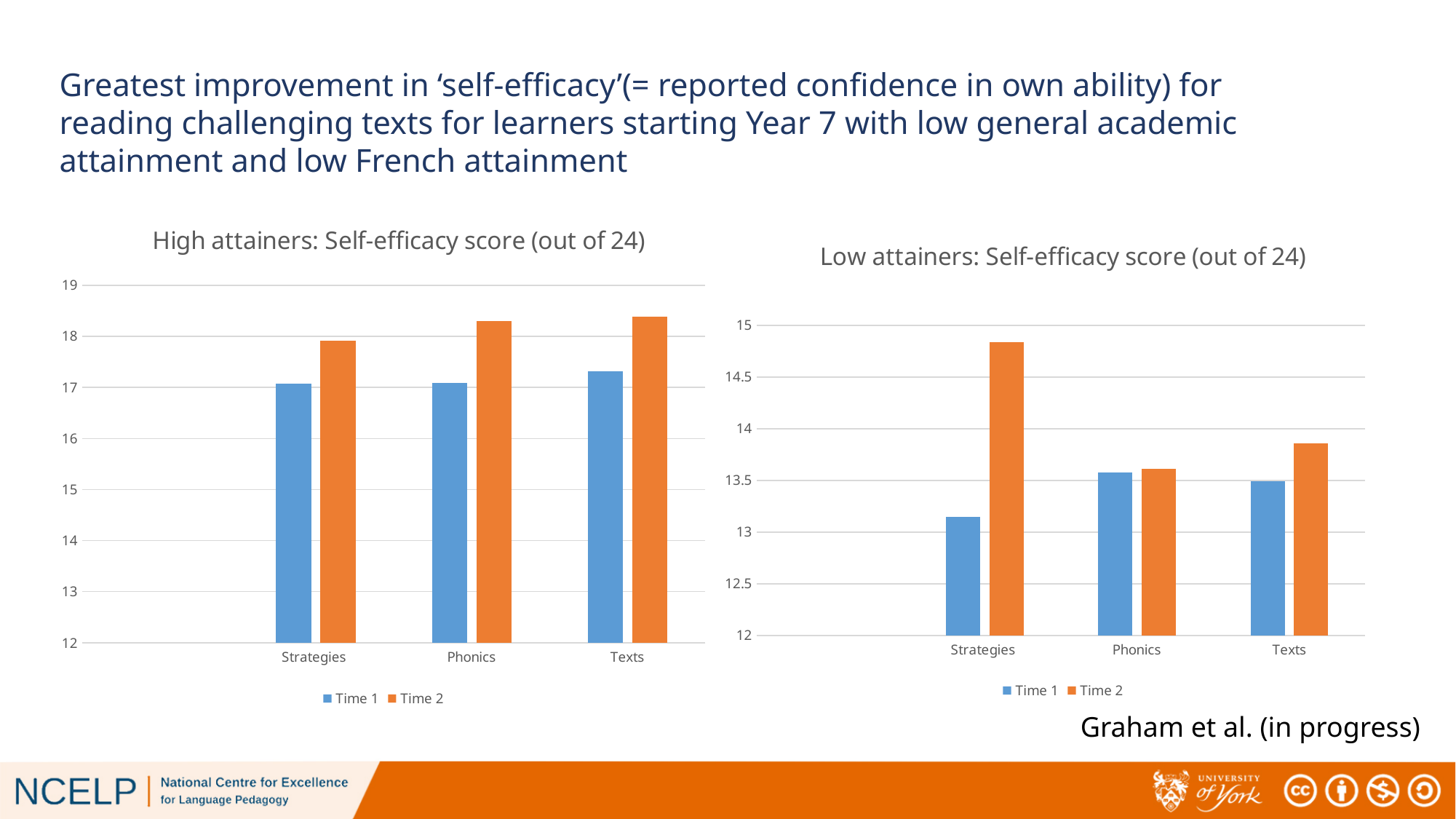
In the 'Low attainers: Self-efficacy score (out of 24)' chart, which category has the highest Time 2 value? Strategies What kind of chart is the 'High attainers: Self-efficacy score (out of 24)' chart? bar chart Which colour represents Time 2 in the 'High attainers: Self-efficacy score (out of 24)' chart? orange In the 'Low attainers: Self-efficacy score (out of 24)' chart, is the Time 2 value for Texts greater or less than 14? less How many categories are shown on the x axis of the 'High attainers: Self-efficacy score (out of 24)' chart? 3 In the 'High attainers: Self-efficacy score (out of 24)' chart, is the Time 2 value for Texts greater or less than 18? greater In the 'Low attainers: Self-efficacy score (out of 24)' chart, is the Time 2 value for Strategies greater or less than 14.5? greater In the 'Low attainers: Self-efficacy score (out of 24)' chart, which category has the lowest Time 1 value? Strategies In the 'High attainers: Self-efficacy score (out of 24)' chart, which is larger: the Time 2 value for Strategies or the Time 1 value for Strategies? Time 2 In the 'Low attainers: Self-efficacy score (out of 24)' chart, which is larger for Strategies: the Time 1 value or the Time 2 value? Time 2 How many series does the legend list in the 'Low attainers: Self-efficacy score (out of 24)' chart? 2